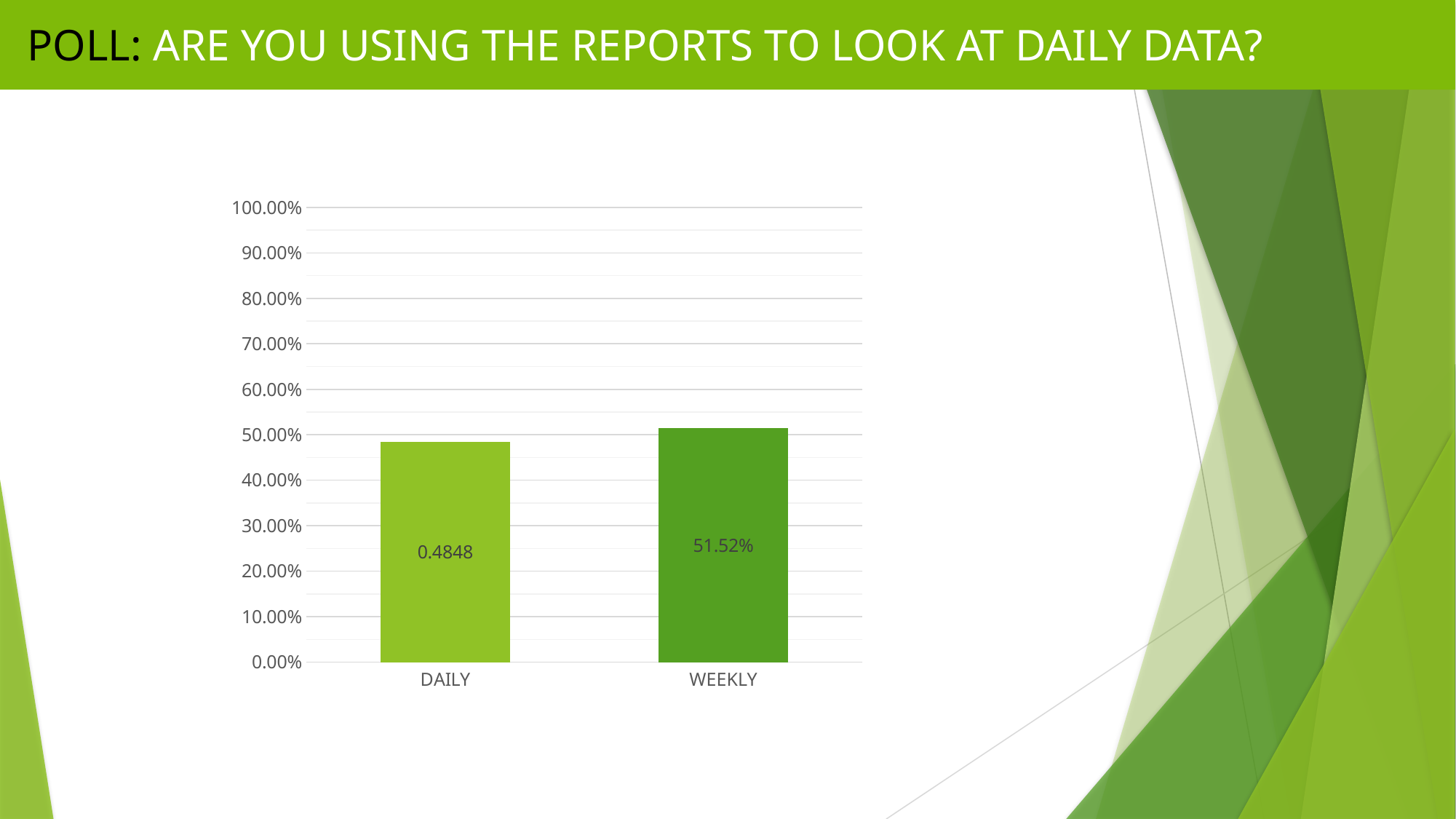
What is the data label shown on the WEEKLY bar? 51.52% Is the value for DAILY greater or less than 50.00%? less What kind of chart is shown on the slide? bar chart Is the value for WEEKLY greater or less than 60.00%? less How many categories are shown on the x axis of the chart? 2 Is the value for WEEKLY greater or less than 50.00%? greater Which category has the lowest value in the chart? DAILY What is the highest value shown on the y axis of the chart? 100.00% Which category has the highest value in the chart? WEEKLY What is the data label shown on the DAILY bar? 0.4848 Which category has the higher value, DAILY or WEEKLY? WEEKLY Which bar is drawn in the darker shade of green, DAILY or WEEKLY? WEEKLY